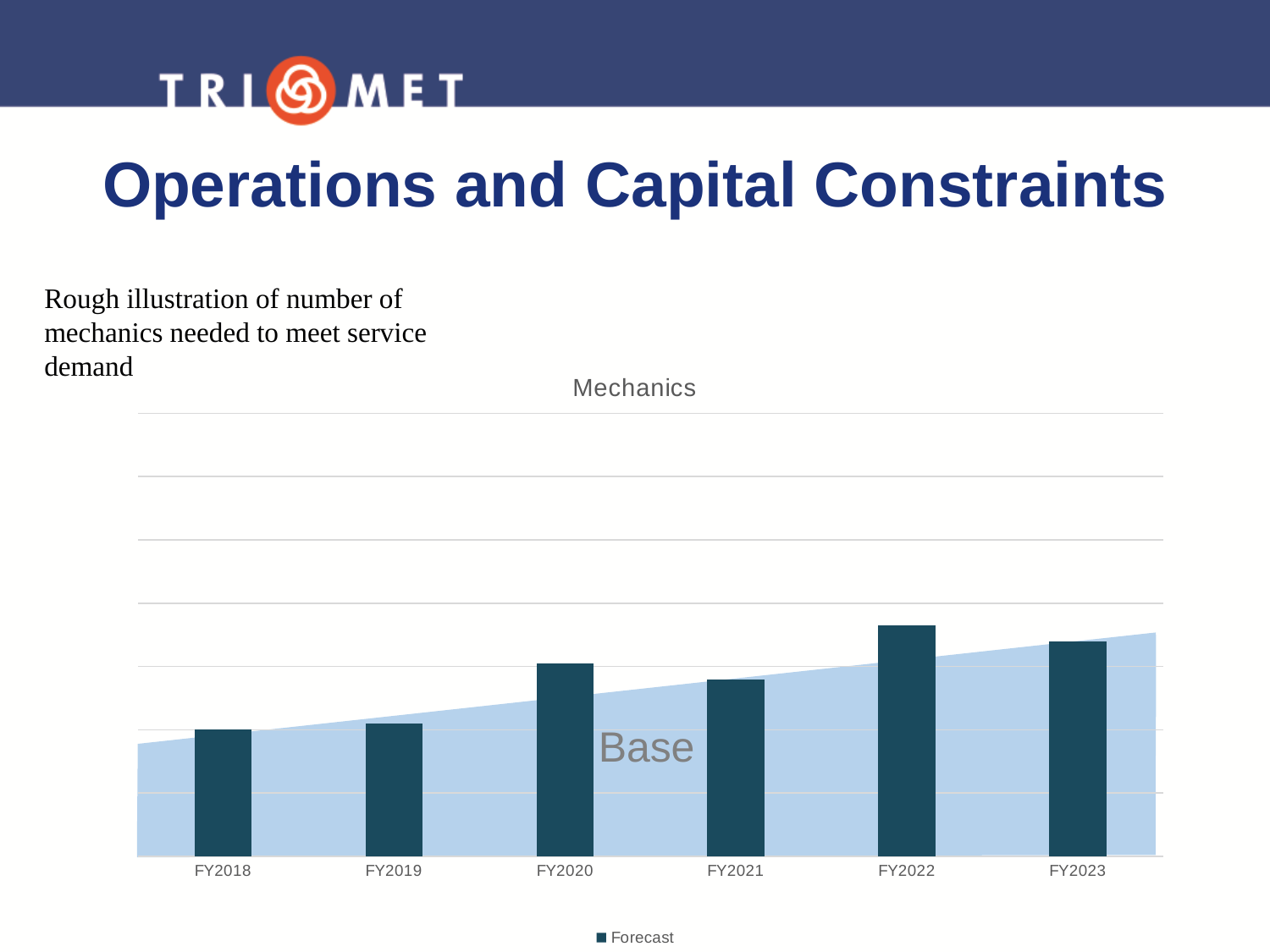
Which is larger, the Forecast value for FY2022 or for FY2023? FY2022 Does the shaded Base area rise or fall from FY2018 to FY2023? rise What kind of chart is used to show the Forecast series? bar chart Do the Forecast bars generally rise or fall from FY2018 to FY2023? rise Which fiscal year has the highest Forecast bar? FY2022 Is the Forecast bar for FY2020 taller or shorter than the bar for FY2021? taller What is the first fiscal year shown on the x axis? FY2018 How many series does the chart's legend list? 1 What series name appears in the chart's legend? Forecast How many fiscal years are shown on the x axis of the chart? 6 What is the title of the chart? Mechanics Which is larger, the Forecast value for FY2018 or for FY2020? FY2020